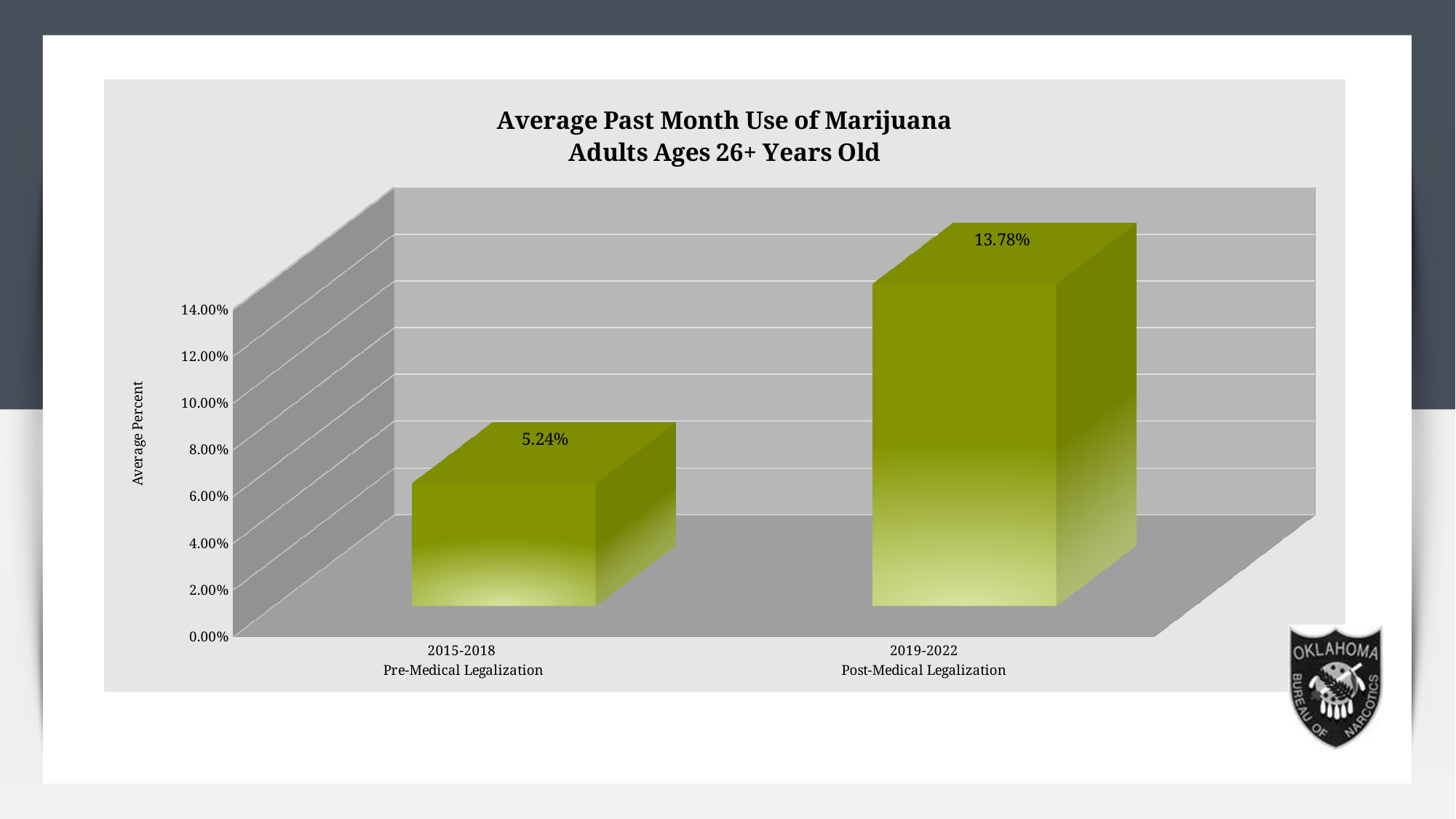
Is the value for 2015-2018 Pre-Medical Legalization greater or less than 8.00%? less What is the value for 2019-2022 Post-Medical Legalization? 13.78% Which category has the lowest value? 2015-2018 Pre-Medical Legalization Which category has the highest value? 2019-2022 Post-Medical Legalization Do the values rise or fall from the 2015-2018 period to the 2019-2022 period? rise What is the title of the chart? Average Past Month Use of Marijuana Adults Ages 26+ Years Old How many categories are shown on the chart? 2 What is the value for 2015-2018 Pre-Medical Legalization? 5.24% What is the difference between the 2019-2022 Post-Medical Legalization value and the 2015-2018 Pre-Medical Legalization value? 8.54% Is the value for 2019-2022 Post-Medical Legalization greater or less than 10.00%? greater Which is larger, the value for 2015-2018 Pre-Medical Legalization or the value for 2019-2022 Post-Medical Legalization? 2019-2022 Post-Medical Legalization What kind of chart is shown on the slide? bar chart